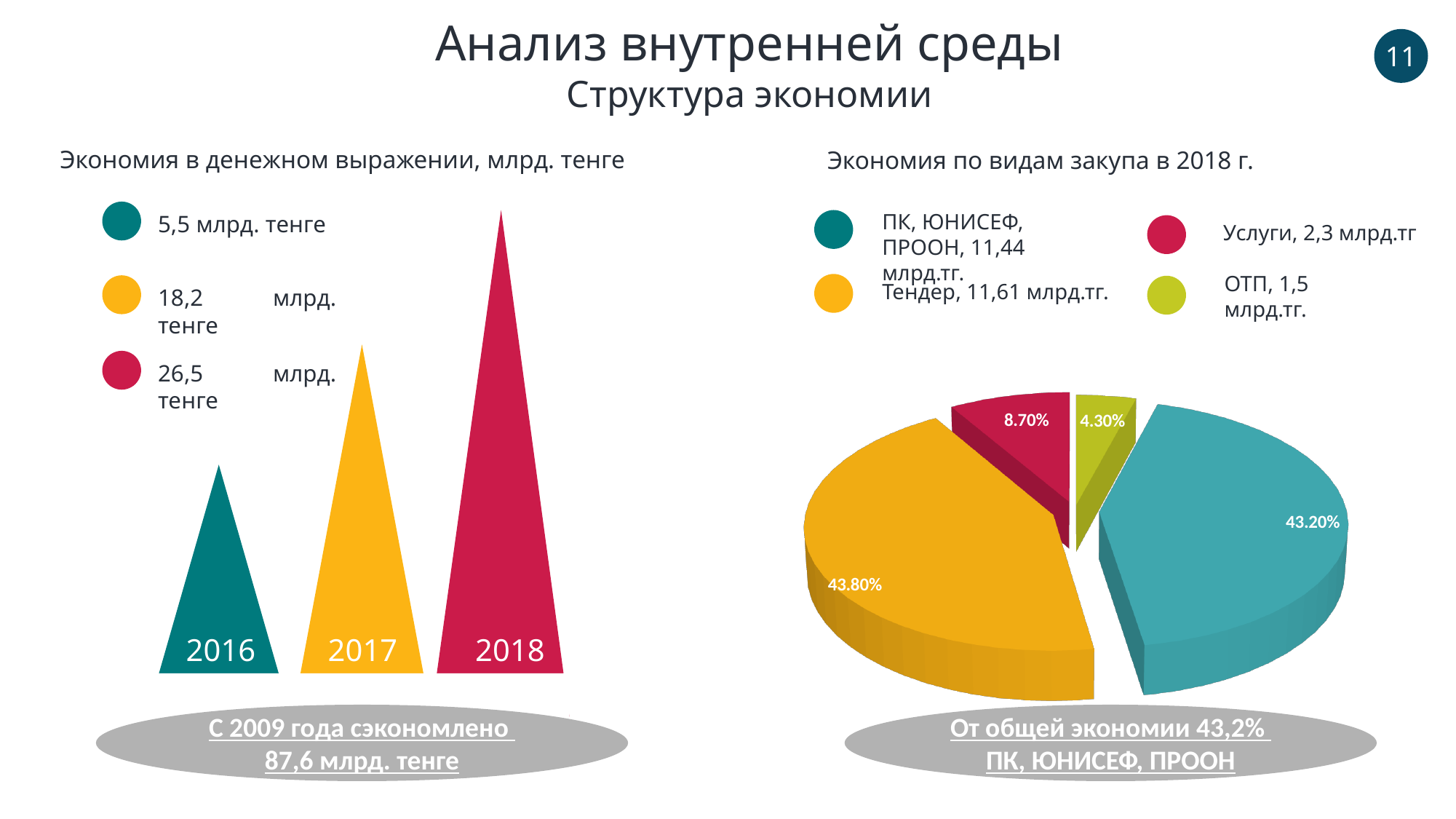
What kind of chart is the right chart 'Экономия по видам закупа в 2018 г.'? pie chart In the right chart 'Экономия по видам закупа в 2018 г.', what amount is listed in the legend for Услуги? 2,3 млрд.тг In the left chart 'Экономия в денежном выражении, млрд. тенге', what is the value for 2018? 26,5 млрд. тенге In the right chart 'Экономия по видам закупа в 2018 г.', which category has the smallest slice? ОТП In the left chart 'Экономия в денежном выражении, млрд. тенге', what is the difference between the 2018 and 2016 values? 21 млрд. тенге In the right chart 'Экономия по видам закупа в 2018 г.', what share does ОТП have? 4.30% In the left chart 'Экономия в денежном выражении, млрд. тенге', what is the value for 2016? 5,5 млрд. тенге In the right chart 'Экономия по видам закупа в 2018 г.', what share does Тендер have? 43.80% In the left chart 'Экономия в денежном выражении, млрд. тенге', which year has the lowest value? 2016 How many years are shown in the left chart 'Экономия в денежном выражении, млрд. тенге'? 3 In the left chart 'Экономия в денежном выражении, млрд. тенге', do the values rise or fall from 2016 to 2018? rise In the left chart 'Экономия в денежном выражении, млрд. тенге', which year has the highest value? 2018